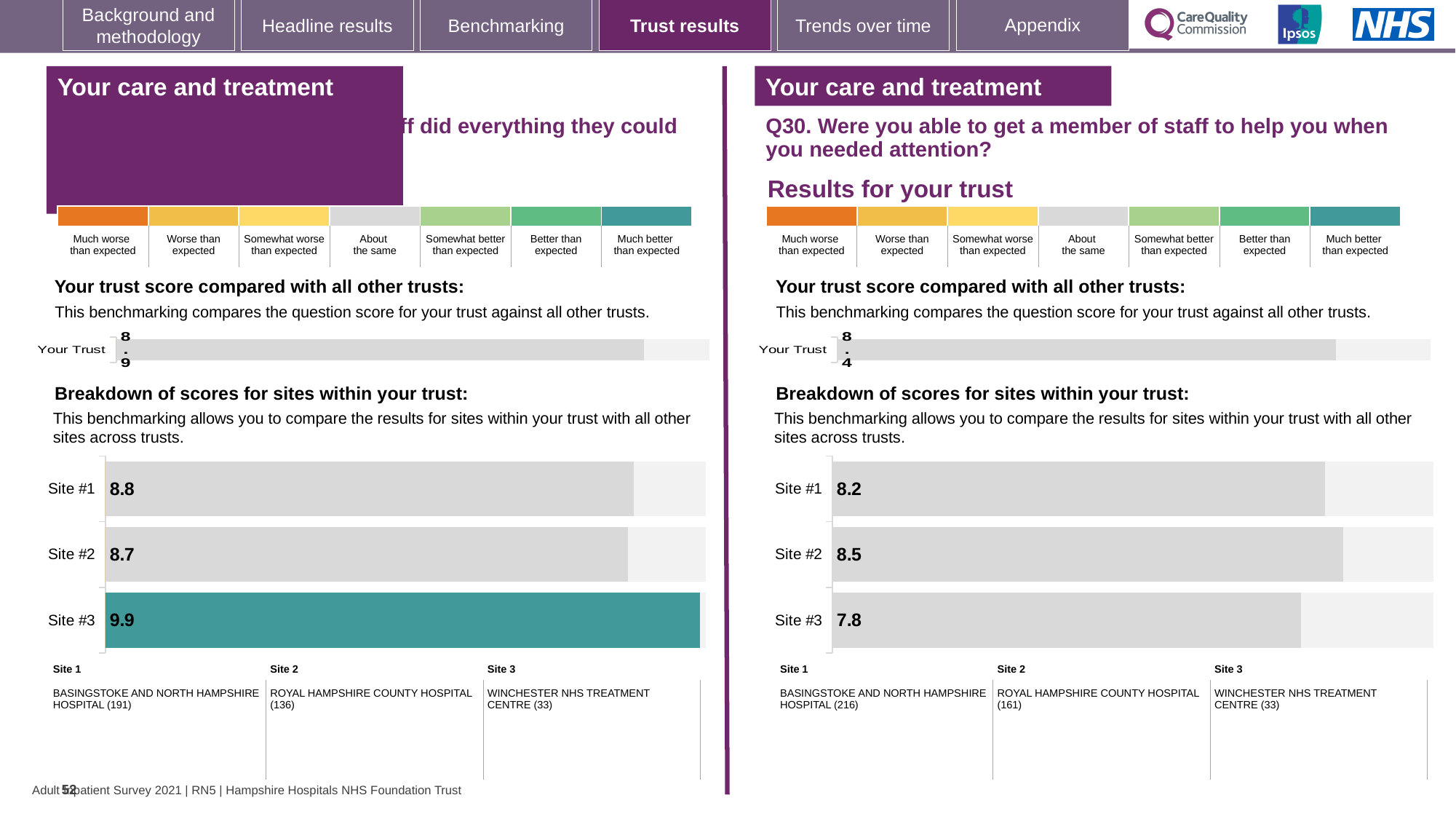
On the left-hand site breakdown chart, what is the difference between the scores for Site #3 and Site #1? 1.1 On the right-hand (Q30) site breakdown chart, what is the score for Site #1? 8.2 On the left-hand site breakdown chart, which site has the highest score? Site #3 On the right-hand (Q30) site breakdown chart, which site has the highest score? Site #2 On the left-hand site breakdown chart, what is the score for Site #2? 8.7 On the right-hand (Q30) site breakdown chart, what is the score for Site #3? 7.8 On the right-hand (Q30) site breakdown chart, which site has the lowest score? Site #3 How many sites are shown in the left-hand site breakdown chart? 3 What type of chart is used for the site breakdown on the right-hand (Q30) side? Bar chart On the right-hand (Q30) 'Your Trust' chart, what is the trust score shown? 8.4 On the right-hand (Q30) site breakdown chart, what is the difference between the scores for Site #2 and Site #3? 0.7 On the left-hand 'Your Trust' chart, what is the trust score shown? 8.9